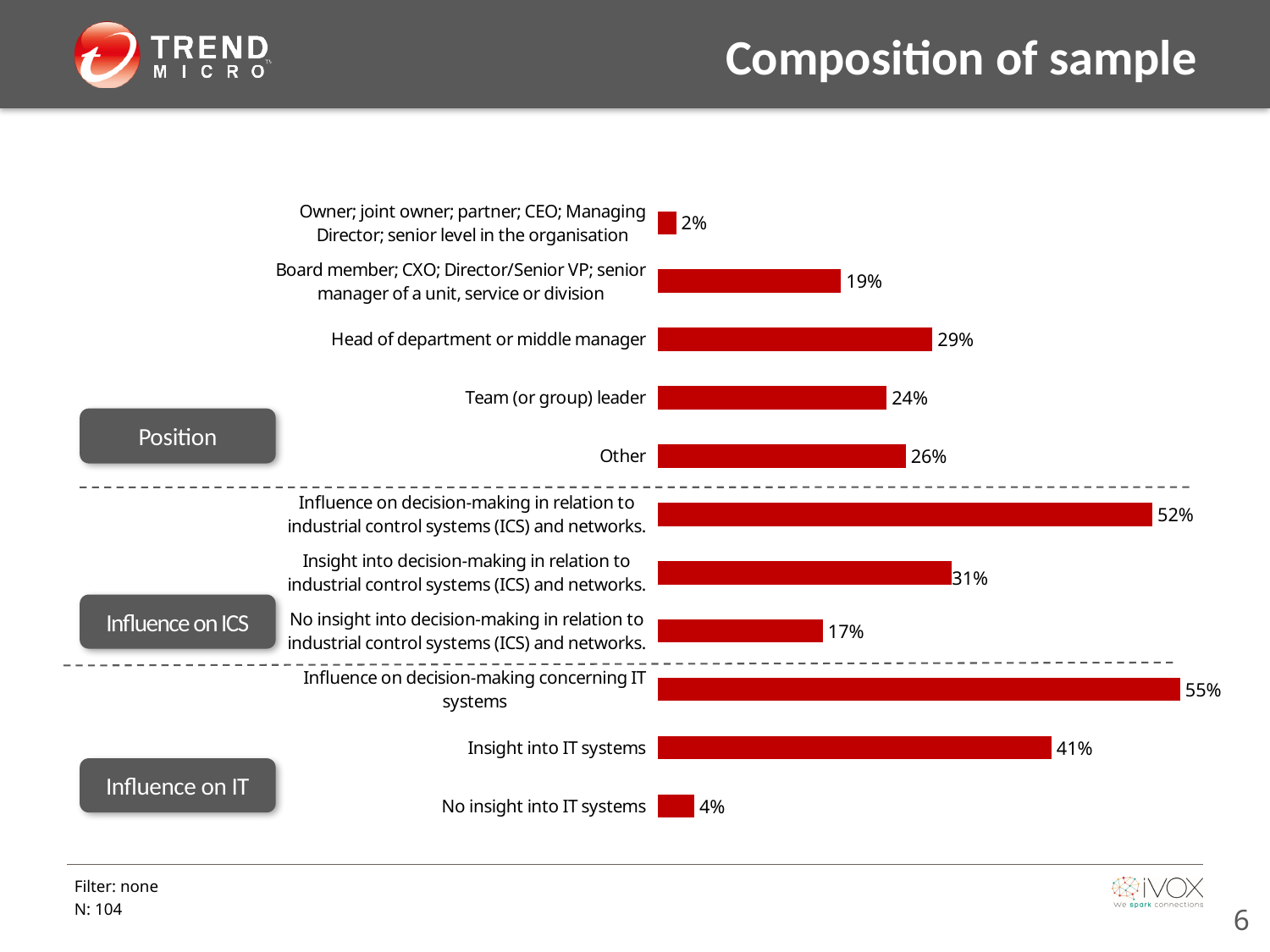
What kind of chart is shown on the slide? Bar chart What is the title of the slide? Composition of sample Which is larger: 'Team (or group) leader' or 'Other'? Other What percentage of the sample is 'Head of department or middle manager'? 29% What is the value for 'No insight into IT systems'? 4% How many bars are plotted on the chart? 11 Which category has the highest value on the chart? Influence on decision-making concerning IT systems What is the value for 'Influence on decision-making concerning IT systems'? 55% What is the difference between 'Influence on decision-making in relation to industrial control systems (ICS) and networks.' and 'No insight into decision-making in relation to industrial control systems (ICS) and networks.'? 35% What is the value for 'Insight into decision-making in relation to industrial control systems (ICS) and networks.'? 31% Which is larger: 'Insight into IT systems' or 'Head of department or middle manager'? Insight into IT systems Which category has the lowest value on the chart? Owner; joint owner; partner; CEO; Managing Director; senior level in the organisation